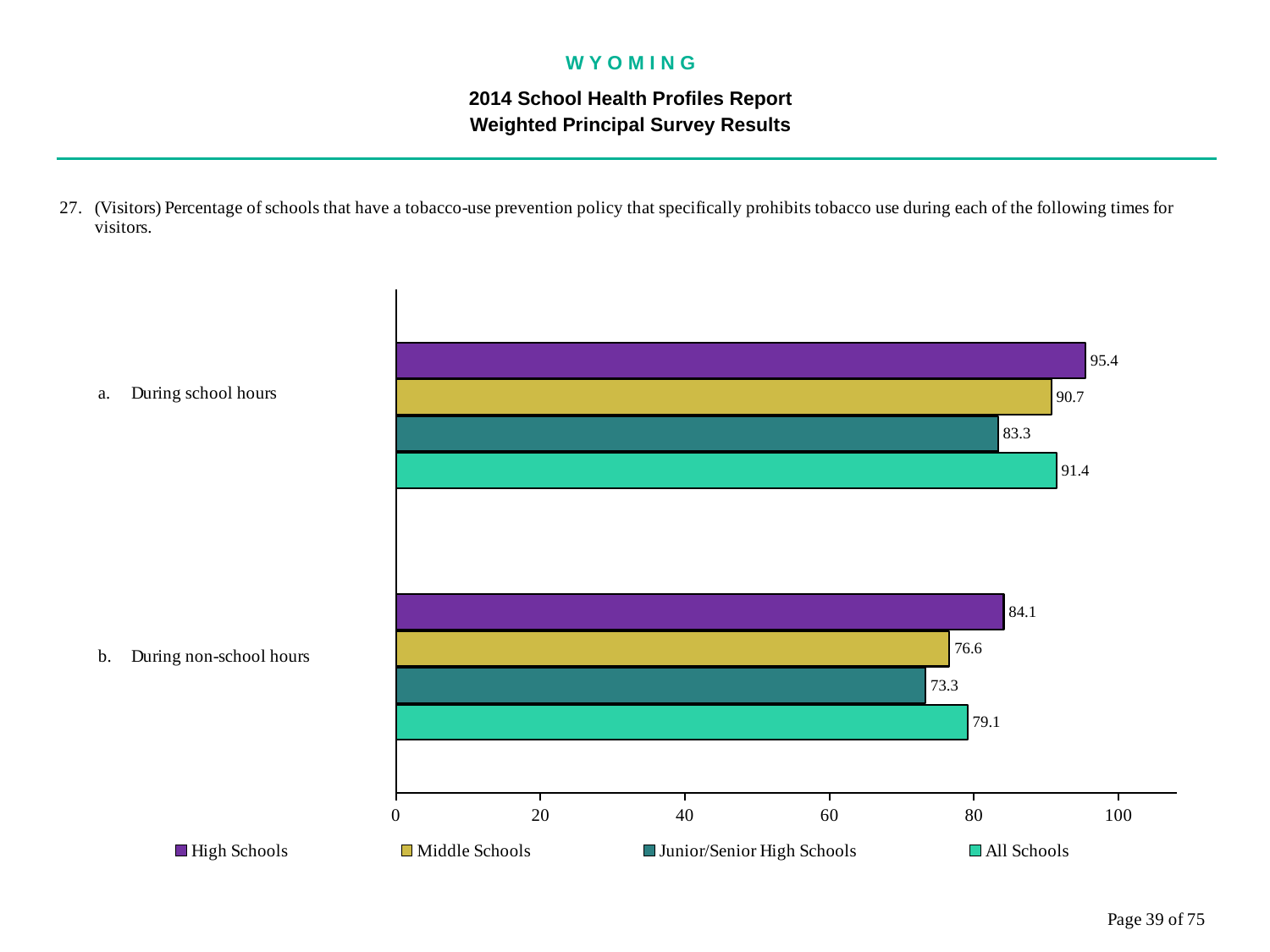
What is the value for High Schools during school hours? 95.4 Which school type has the highest value during non-school hours? High Schools Which colour represents Middle Schools in the legend? yellow Which school type has the lowest value during school hours? Junior/Senior High Schools What is the value for Middle Schools during non-school hours? 76.6 What is the value for All Schools during school hours? 91.4 What kind of chart is shown on the slide? bar chart What is the value for Junior/Senior High Schools during non-school hours? 73.3 How many series does the legend list? 4 Which is larger: the Middle Schools value during school hours or the All Schools value during school hours? All Schools Is the value for All Schools during non-school hours greater or less than 80? less What is the difference between the High Schools values during school hours and during non-school hours? 11.3